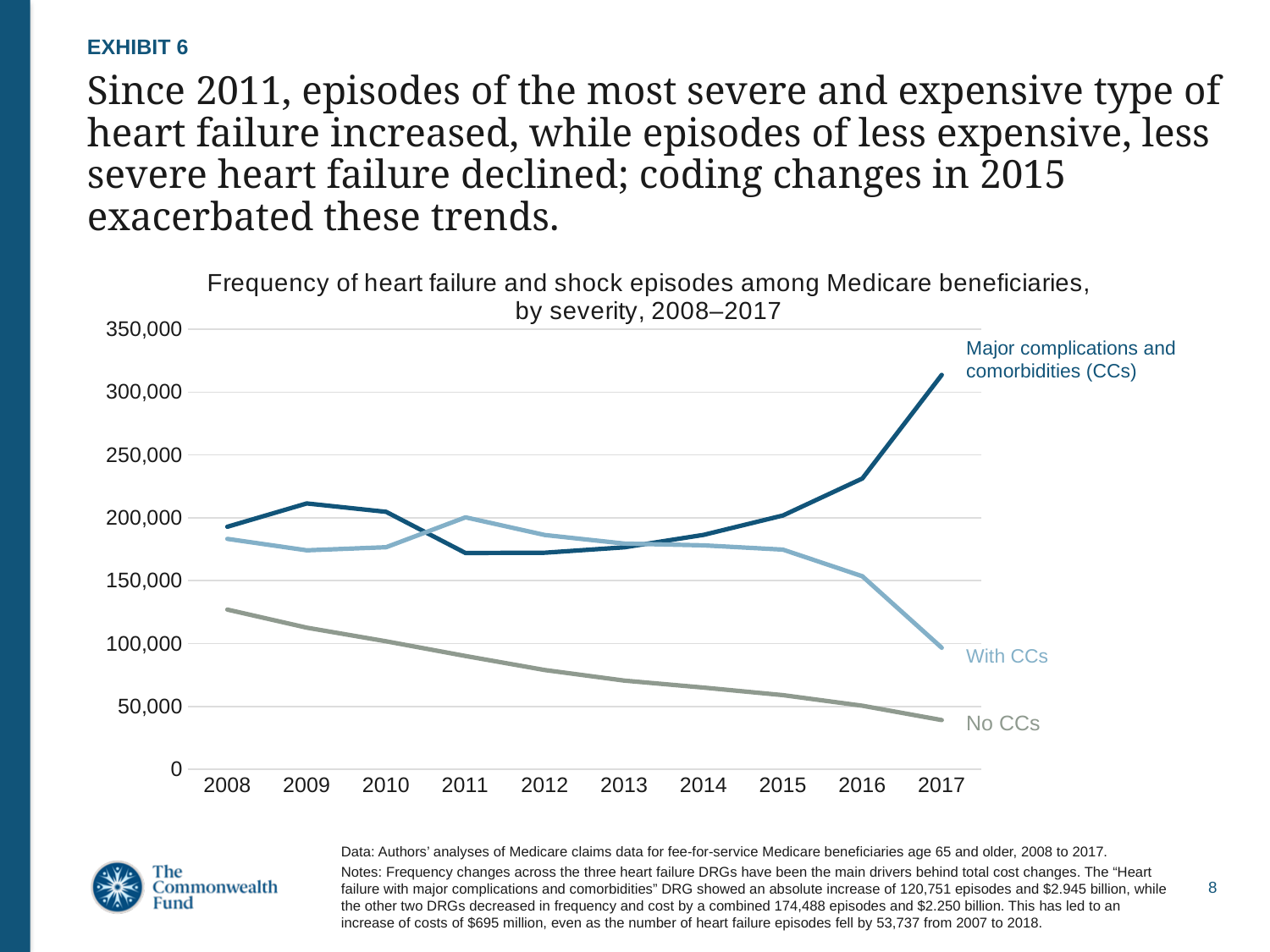
What kind of chart is shown on the slide? Line chart What is the title of the chart? Frequency of heart failure and shock episodes among Medicare beneficiaries, by severity, 2008–2017 Is the value for No CCs in 2017 greater or less than 50,000? less Which series has the lowest value in 2008? No CCs Which series has the lowest value in 2017? No CCs Is the value for No CCs in 2008 greater or less than 100,000? greater Does the No CCs series rise or fall from 2008 to 2017? Fall Is the value for Major complications and comorbidities (CCs) in 2017 greater or less than 300,000? greater Which series has the highest value in 2017? Major complications and comorbidities (CCs) How many years are shown along the x axis? 10 In 2011, which is larger: the value for With CCs or the value for Major complications and comorbidities (CCs)? With CCs How many series are plotted on the chart? 3